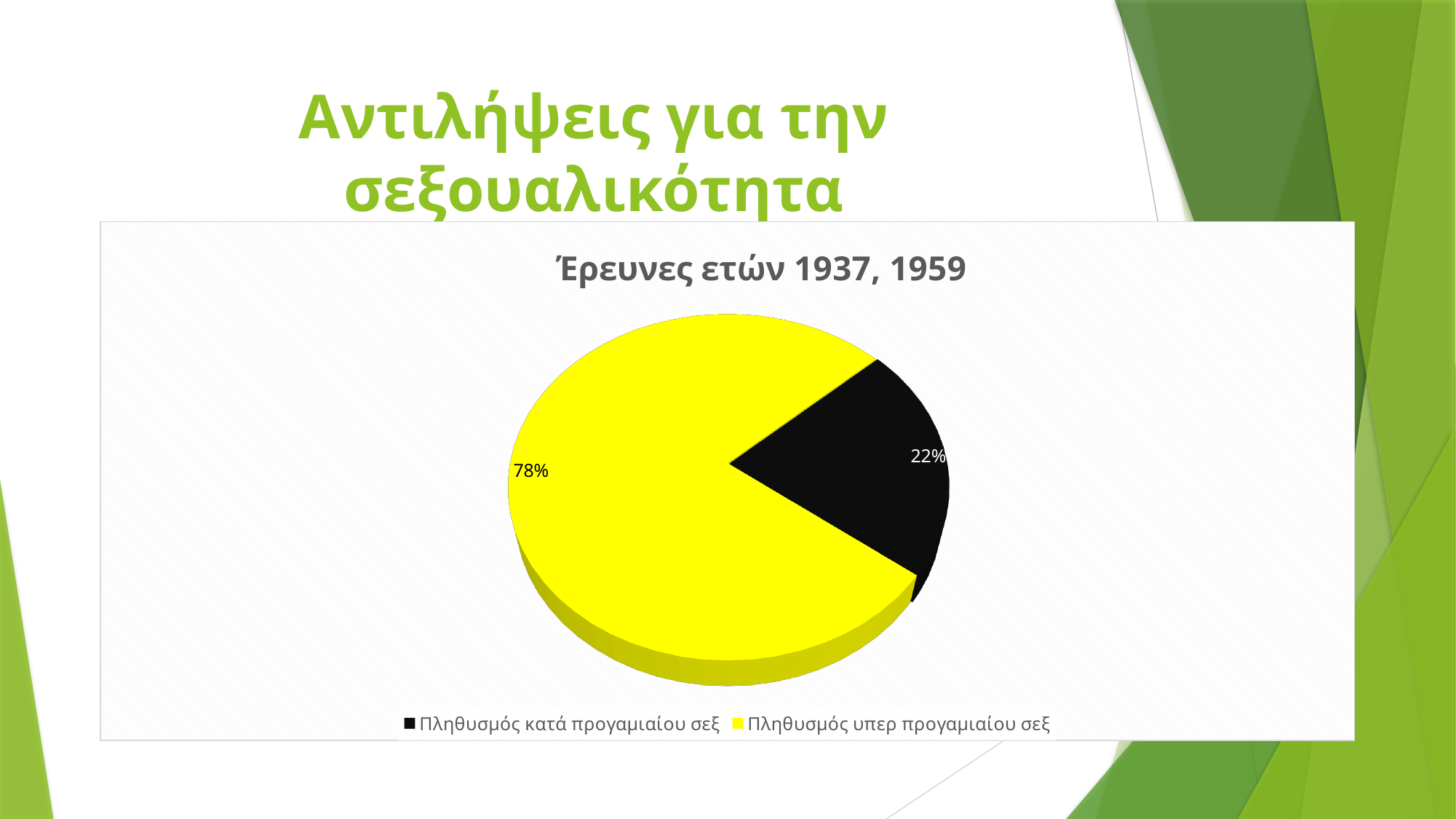
Which category has the smallest slice of the pie? Πληθυσμός κατά προγαμιαίου σεξ What share of the pie is labelled for 'Πληθυσμός κατά προγαμιαίου σεξ'? 22% What colour is the slice for 'Πληθυσμός κατά προγαμιαίου σεξ'? black Which is larger: the slice for 'Πληθυσμός κατά προγαμιαίου σεξ' or the slice for 'Πληθυσμός υπερ προγαμιαίου σεξ'? Πληθυσμός υπερ προγαμιαίου σεξ What is the difference in percentage points between the 'Πληθυσμός υπερ προγαμιαίου σεξ' slice and the 'Πληθυσμός κατά προγαμιαίου σεξ' slice? 56% What is the title of the chart? Έρευνες ετών 1937, 1959 What share of the pie is labelled for 'Πληθυσμός υπερ προγαμιαίου σεξ'? 78% What type of chart is shown on the slide? pie chart How many slices does the pie chart have? 2 Which category has the largest slice of the pie? Πληθυσμός υπερ προγαμιαίου σεξ How many entries does the legend list? 2